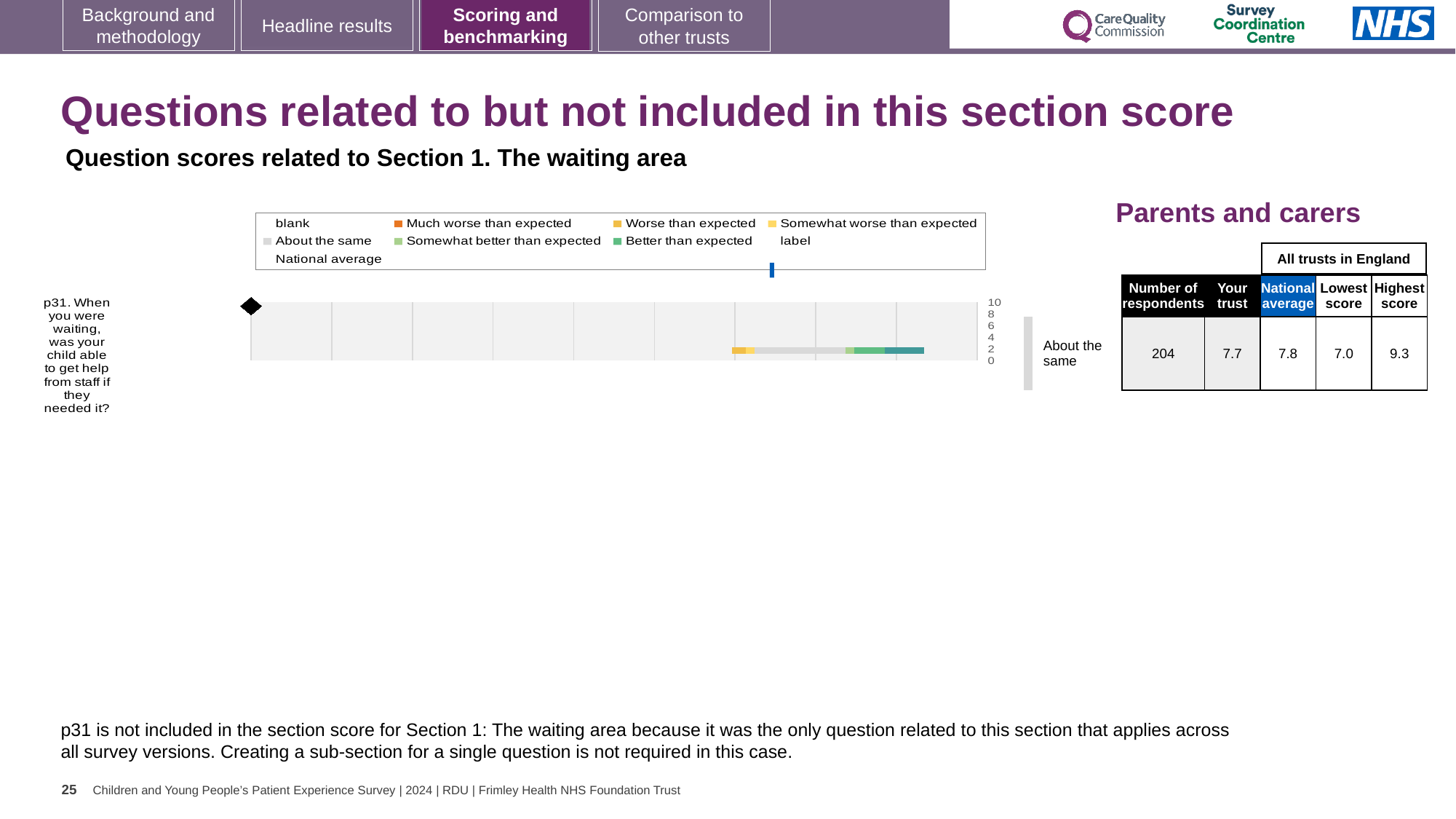
How many entries does the chart legend list? 9 Which question is plotted in the chart? p31. When you were waiting, was your child able to get help from staff if they needed it? How many respondents answered p31 according to the table? 204 In the table, what is the Highest score across all trusts in England for p31? 9.3 What benchmark category label is shown next to the bar for p31? About the same In the table, what is the National average score for p31? 7.8 In the table, what is the 'Your trust' score for p31? 7.7 What kind of chart is shown for question p31? bar chart In the table, what is the Lowest score across all trusts in England for p31? 7.0 What is the highest tick value shown on the chart's axis? 10 How many questions are plotted in the chart? 1 What is the difference between the Highest score and the Lowest score for p31 in the table? 2.3